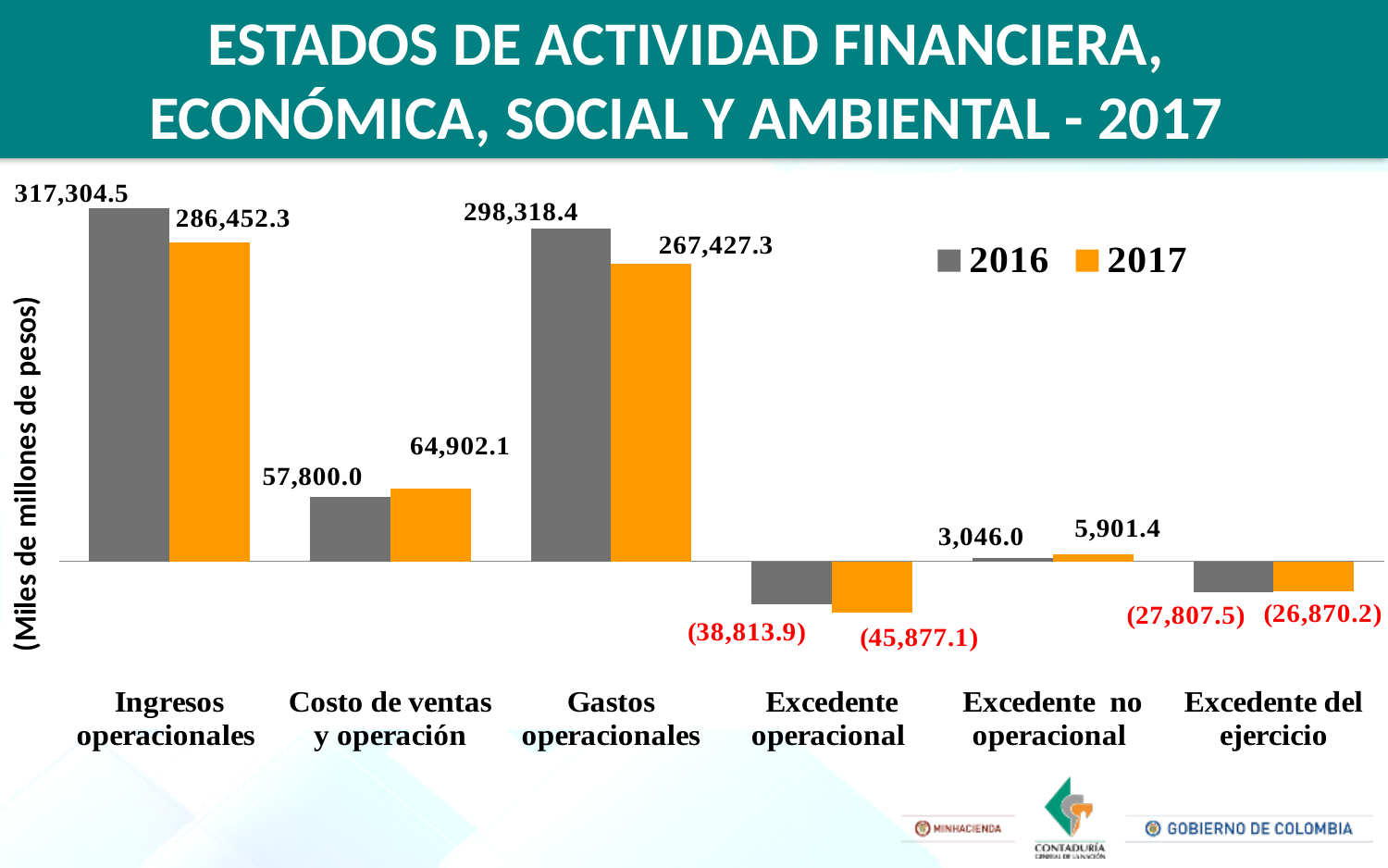
Which category has the lowest 2017 value? Excedente operacional What is the 2016 value for Excedente no operacional? 3,046.0 How many series does the legend list? 2 What is the difference between the 2016 and 2017 values for Ingresos operacionales? 30,852.2 What is the 2017 value for Gastos operacionales? 267,427.3 Which is larger for Costo de ventas y operación, the 2016 value or the 2017 value? 2017 What is the 2016 value for Ingresos operacionales? 317,304.5 How many categories are shown on the x axis? 6 Which category has the highest 2016 value? Ingresos operacionales What is the 2017 value for Excedente operacional? (45,877.1) What kind of chart is shown on the slide? Bar chart What unit is given on the vertical axis label? Miles de millones de pesos